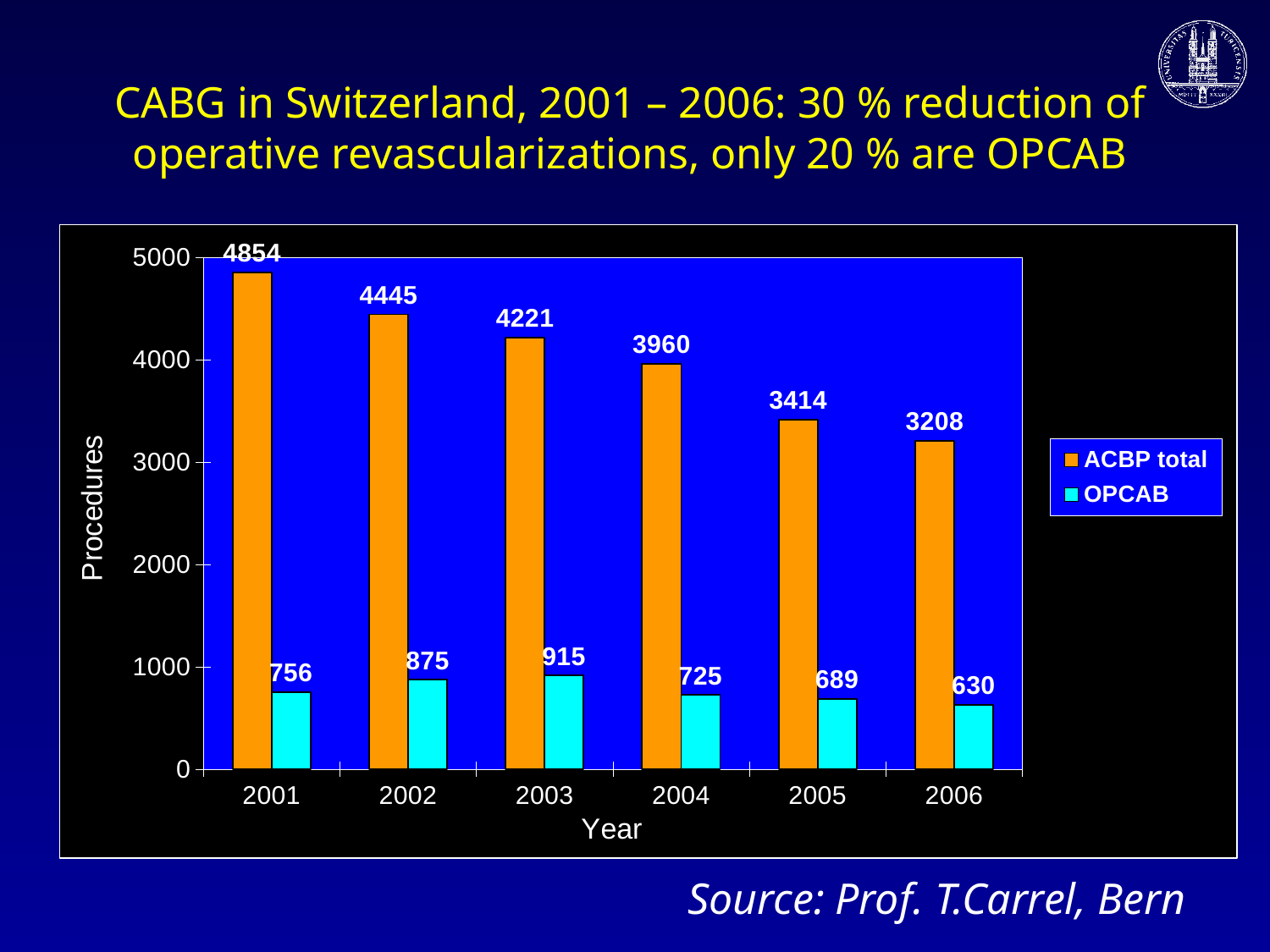
What is the ACBP total value for 2001? 4854 Which year has the highest OPCAB value? 2003 What is the difference between the ACBP total values for 2001 and 2006? 1646 Is the ACBP total value for 2004 greater or less than 4000? less Which is larger, the OPCAB value for 2002 or for 2005? 2002 How many series does the legend list? 2 What kind of chart is shown on the slide? bar chart How many years are shown on the x axis? 6 Which year has the lowest ACBP total value? 2006 What is the OPCAB value for 2003? 915 Do the ACBP total values rise or fall from 2001 to 2006? fall What is the ACBP total value for 2006? 3208